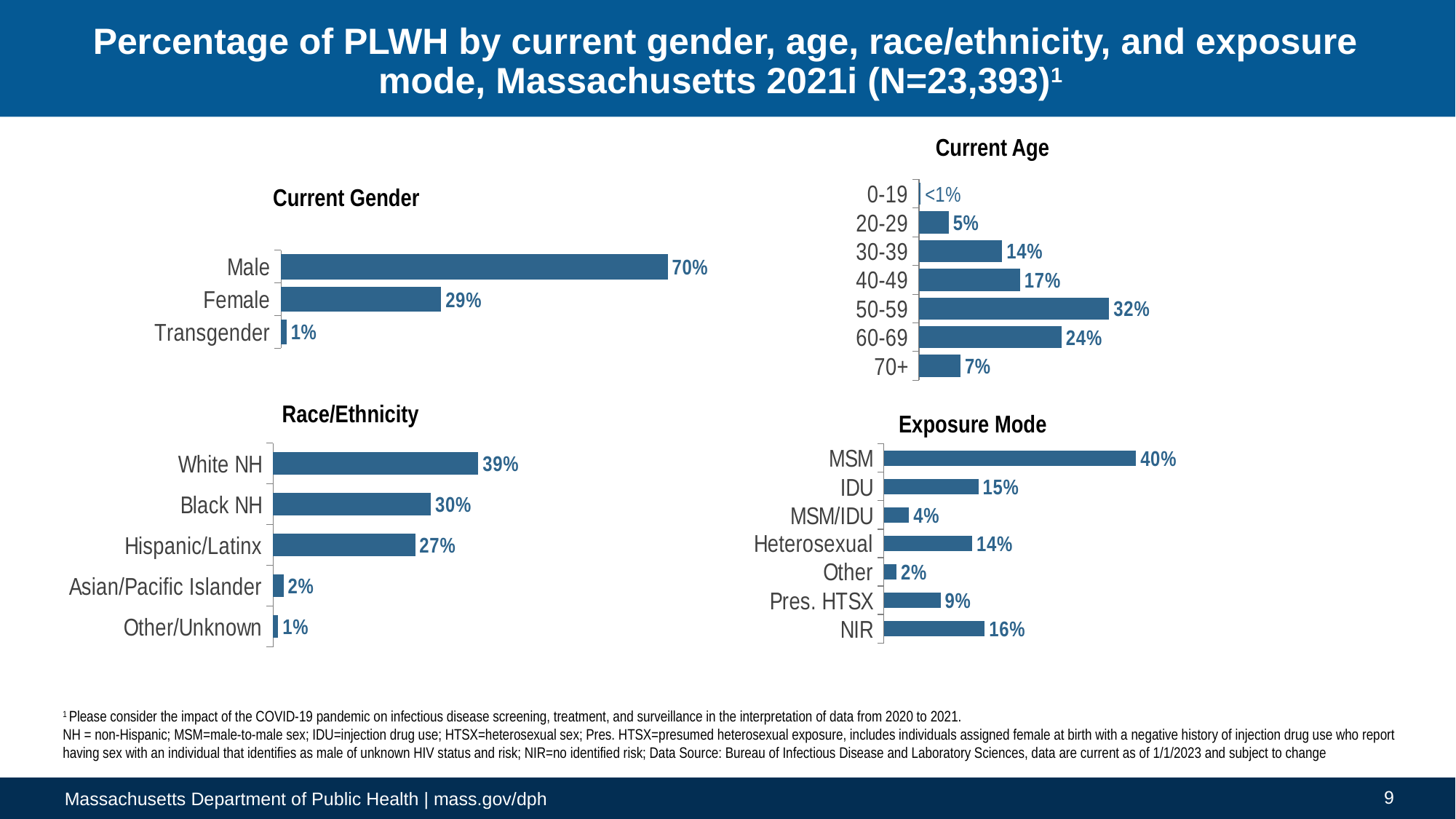
In the Race/Ethnicity chart, what percentage is shown for Hispanic/Latinx? 27% In the Current Gender chart, what percentage is shown for Male? 70% What type of chart is the Exposure Mode chart? Bar chart In the Current Age chart, what percentage is shown for 60-69? 24% In the Current Age chart, how many age groups are shown? 7 In the Race/Ethnicity chart, which category has the lowest percentage? Other/Unknown In the Exposure Mode chart, which category has the highest percentage? MSM In the Exposure Mode chart, what percentage is shown for Pres. HTSX? 9% In the Current Gender chart, what is the difference between the Male and Female percentages? 41% In the Current Age chart, which age group has the highest percentage? 50-59 In the Race/Ethnicity chart, what is the difference between White NH and Black NH? 9% In the Exposure Mode chart, which is larger, IDU or NIR? NIR